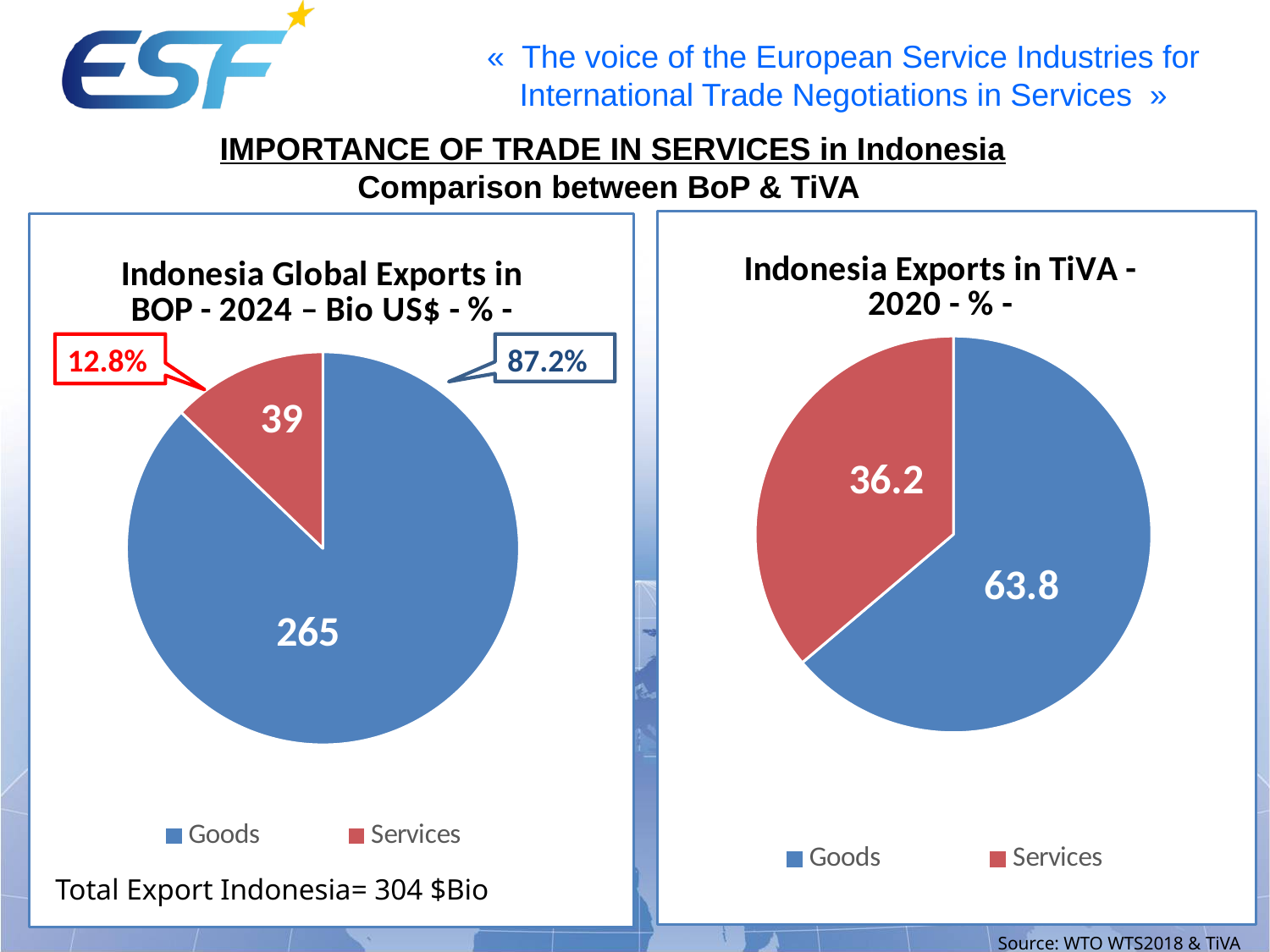
In the 'Indonesia Global Exports in BOP - 2024' chart, what is the difference between the Goods and Services values? 226 In the 'Indonesia Exports in TiVA - 2020' chart, what is the difference between the Goods and Services values? 27.6 In the 'Indonesia Global Exports in BOP - 2024' chart, what is the value for Goods? 265 In the 'Indonesia Exports in TiVA - 2020' chart, what is the value for Services? 36.2 In the 'Indonesia Exports in TiVA - 2020' chart, which category has the largest slice? Goods What kind of chart is the 'Indonesia Exports in TiVA - 2020' chart? Pie chart How many categories does the legend of the 'Indonesia Exports in TiVA - 2020' chart list? 2 In the 'Indonesia Global Exports in BOP - 2024' chart, which category has the smallest slice? Services In the 'Indonesia Global Exports in BOP - 2024' chart, what percentage share is shown for Goods? 87.2% In the 'Indonesia Exports in TiVA - 2020' chart, what is the value for Goods? 63.8 In the 'Indonesia Global Exports in BOP - 2024' chart, what percentage share is shown for Services? 12.8% In the 'Indonesia Global Exports in BOP - 2024' chart, what is the value for Services? 39